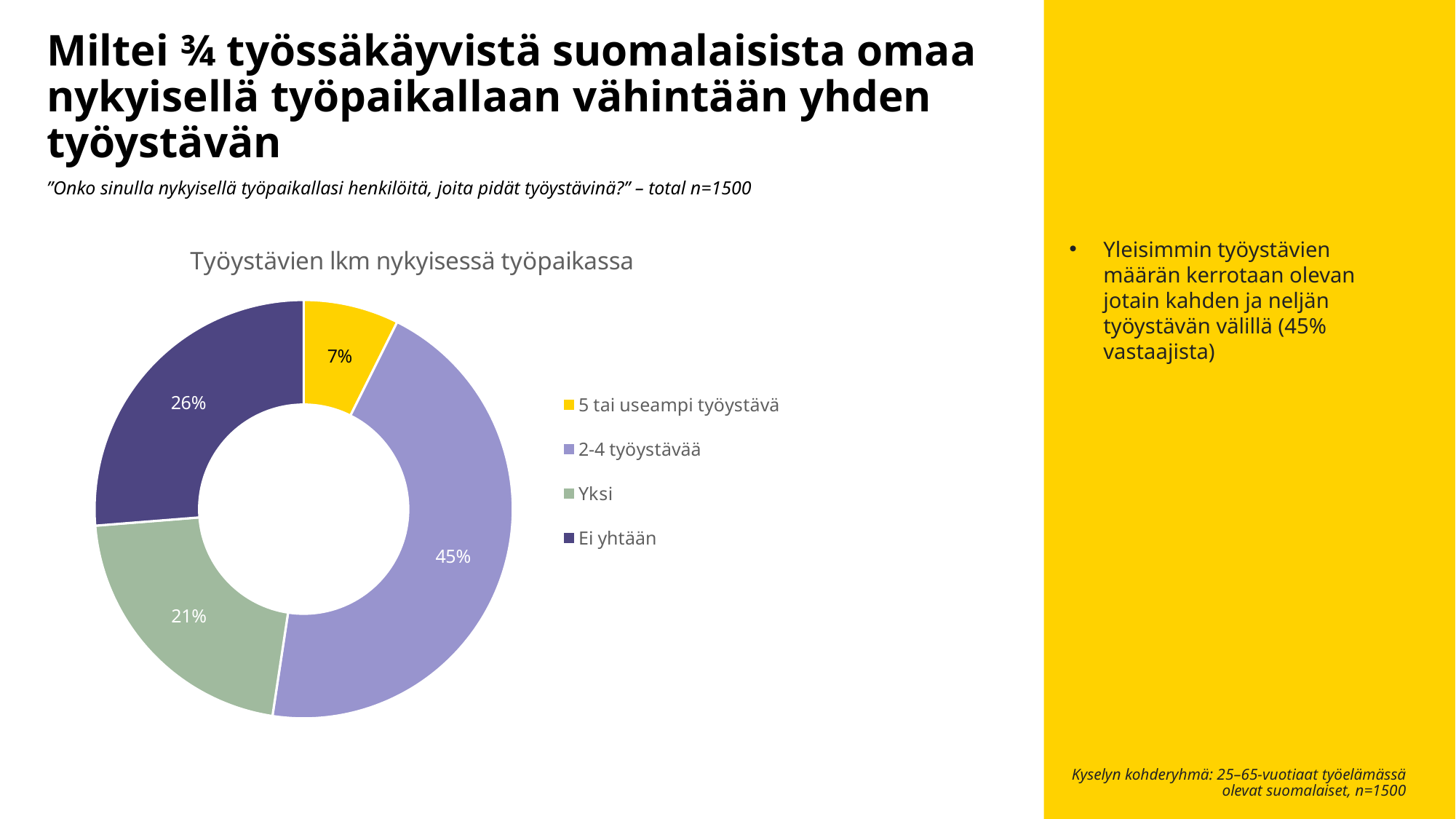
What type of chart is shown on the slide? Doughnut (pie) chart Which category has the largest share of the chart? 2-4 työystävää What percentage of respondents have 5 tai useampi työystävä? 7% Which category has the smallest share of the chart? 5 tai useampi työystävä Which colour represents the 5 tai useampi työystävä category? Yellow What is the title of the chart? Työystävien lkm nykyisessä työpaikassa What percentage of respondents have 2-4 työystävää? 45% What percentage of respondents have Yksi (one) work friend? 21% What percentage of respondents have Ei yhtään (no work friends)? 26% What is the difference in percentage points between the 2-4 työystävää and Ei yhtään categories? 19 Which is larger: the share for Yksi or the share for Ei yhtään? Ei yhtään How many categories are shown in the chart? 4